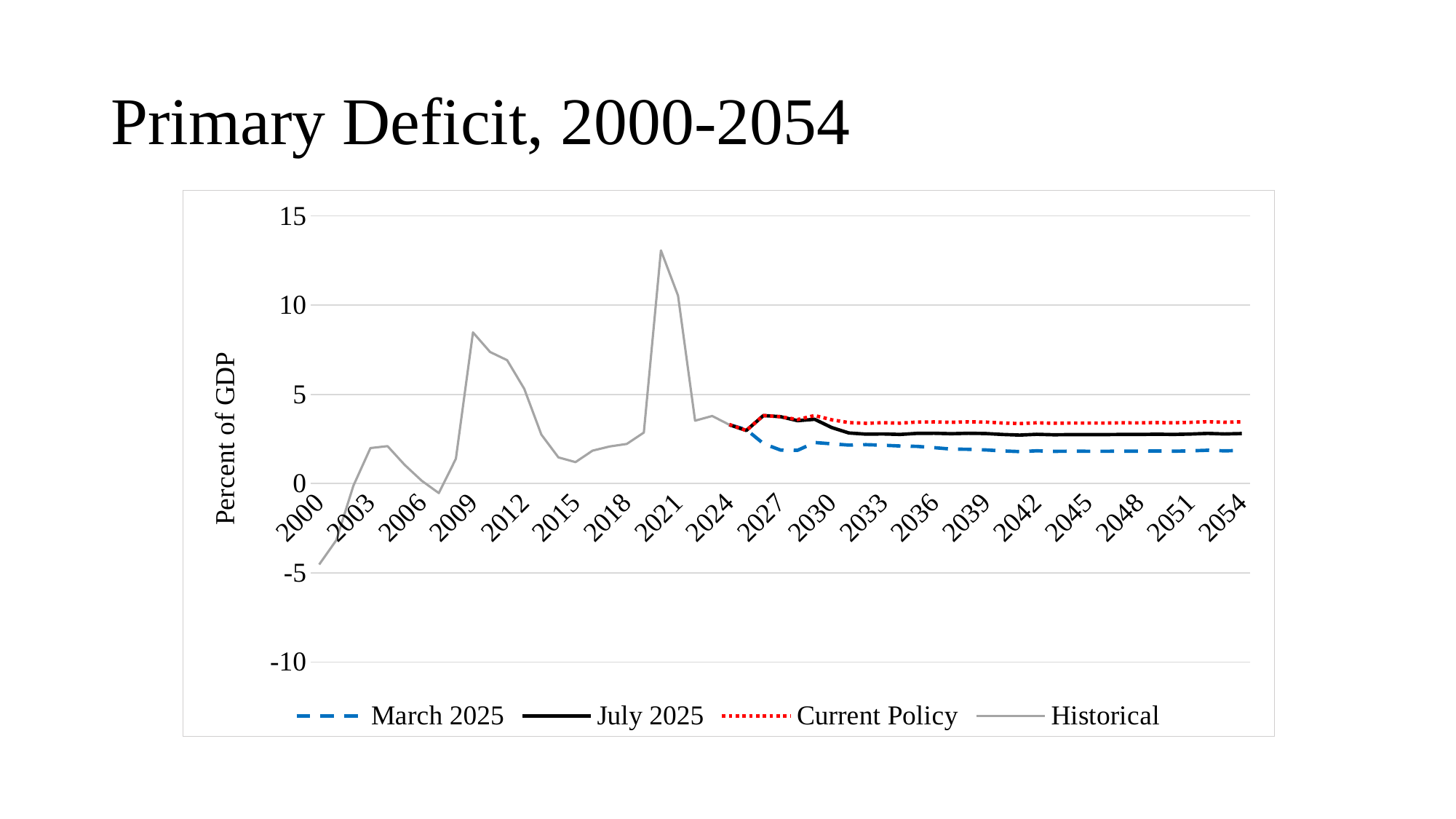
What is the label on the vertical axis? Percent of GDP What are the series names listed in the legend? March 2025, July 2025, Current Policy, Historical Is the value of the Historical series in 2009 greater or less than 5? greater Is the highest value of the Historical series greater or less than 10? greater How many series does the legend list? 4 In 2054, which series is higher, Current Policy or March 2025? Current Policy What kind of chart is shown on the slide? line chart Is the value of the Historical series in 2015 greater or less than 5? less Which series has the lowest value in 2054? March 2025 Which series has the highest value in 2054? Current Policy